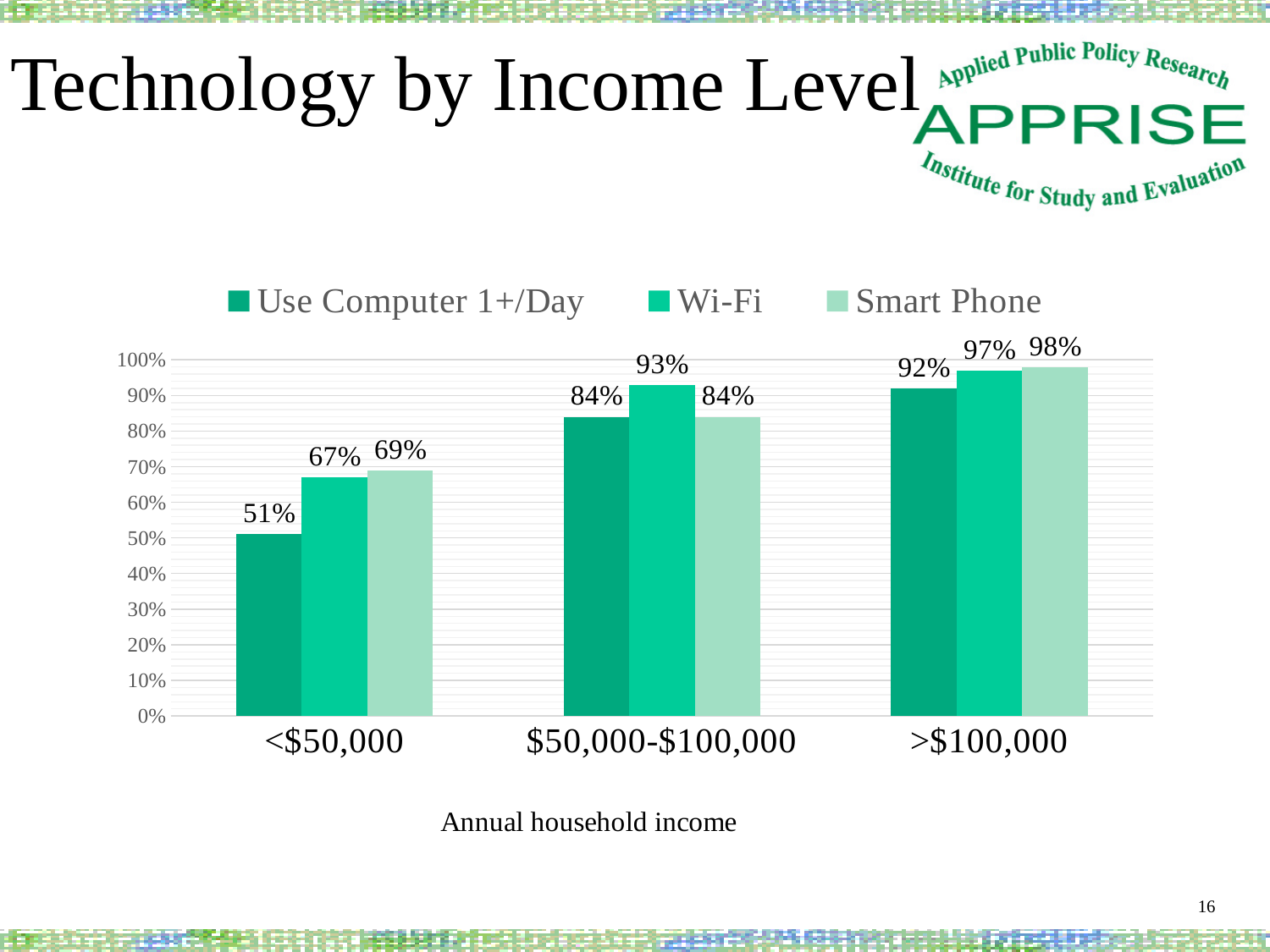
What is the Smart Phone value for the >$100,000 income group? 98% How many income groups are shown on the x axis? 3 How many series does the legend list? 3 What percentage of households with income <$50,000 use a computer 1+/day? 51% What is the Wi-Fi value for the $50,000-$100,000 income group? 93% For the <$50,000 income group, which is larger: Wi-Fi or Use Computer 1+/Day? Wi-Fi What is the difference between the Smart Phone values for the >$100,000 and <$50,000 income groups? 29 percentage points Do the Use Computer 1+/Day values rise or fall as income level increases along the x axis? Rise What is the x-axis label of the chart? Annual household income Which income group has the highest Wi-Fi value? >$100,000 Which income group has the lowest Use Computer 1+/Day value? <$50,000 What kind of chart is shown on the slide? Bar chart